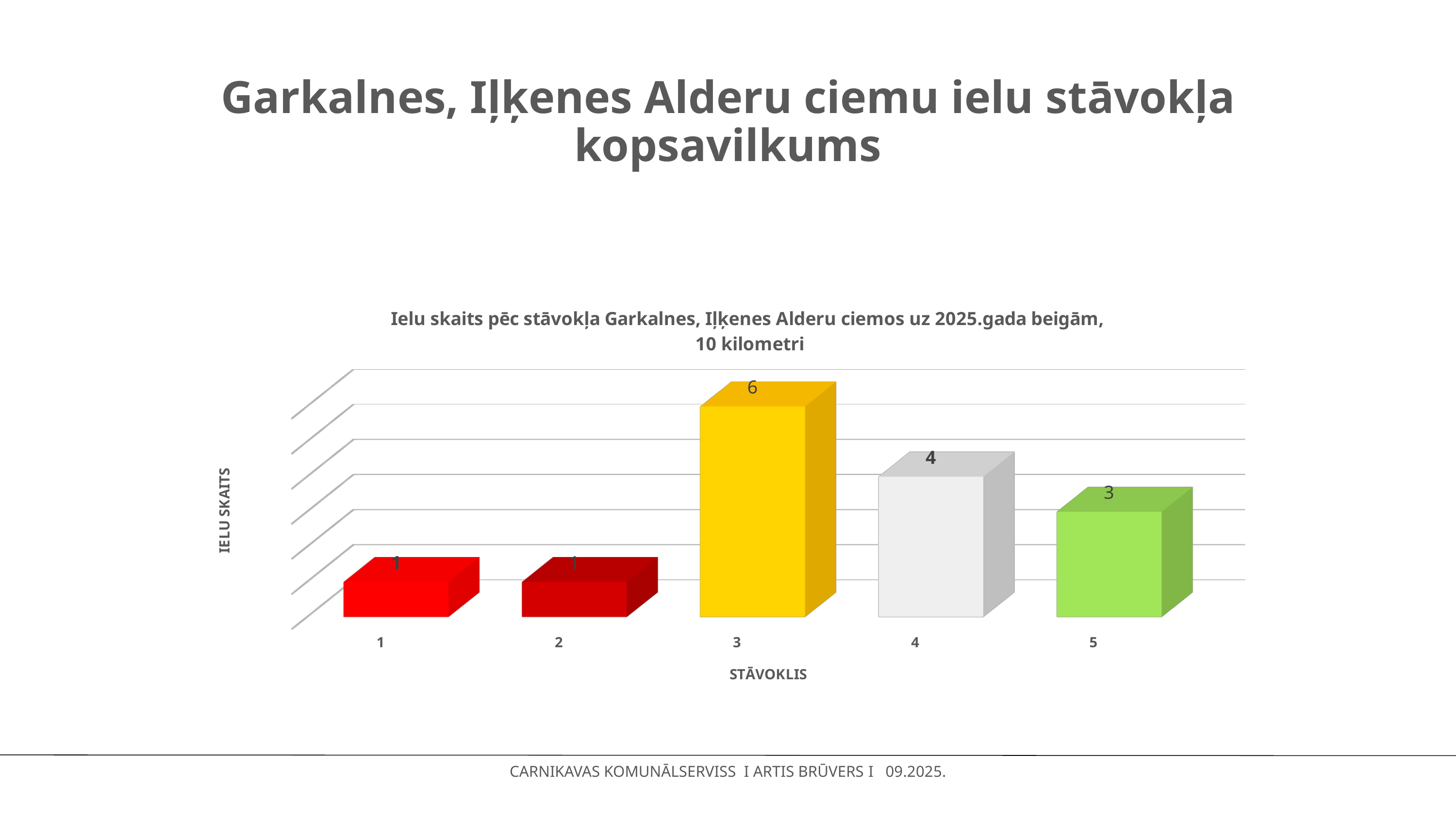
What is the difference between the values for category 4 and category 5? 1 What is the label of the x axis? STĀVOKLIS What kind of chart is shown on the slide? bar chart What is the value for category 1 (stāvoklis 1)? 1 What is the value for category 4 (stāvoklis 4)? 4 How many categories are shown on the x axis? 5 What is the difference between the values for category 3 and category 4? 2 What is the value for category 5 (stāvoklis 5)? 3 What is the value for category 3 (stāvoklis 3)? 6 Which category has the highest value? 3 What is the label of the y axis? IELU SKAITS Which is larger, the value for category 4 or the value for category 5? category 4